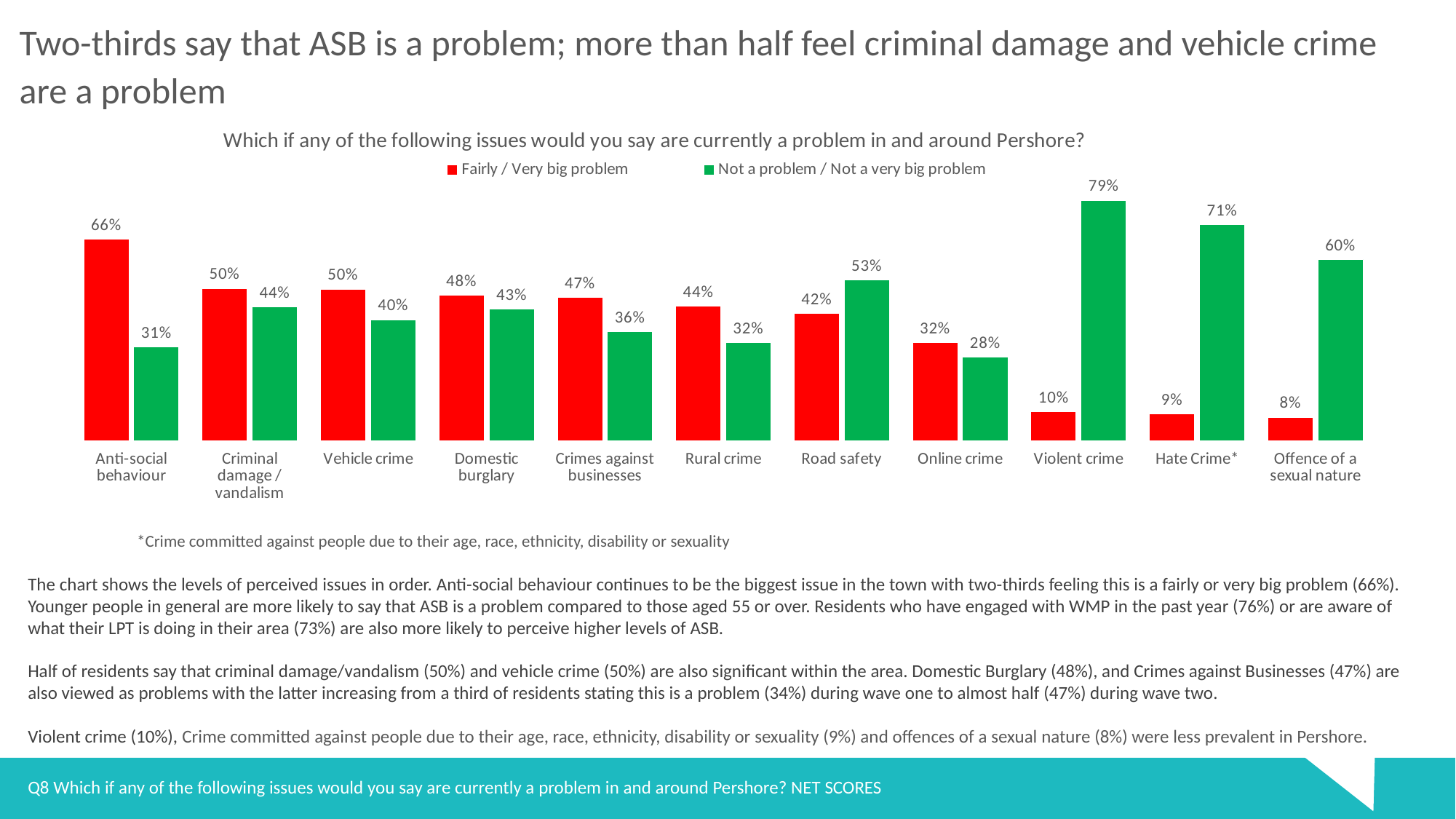
Which category has the lowest 'Fairly / Very big problem' value? Offence of a sexual nature How many categories are shown on the x axis? 11 What percentage say violent crime is not a problem / not a very big problem? 79% For rural crime, which is larger: the 'Fairly / Very big problem' value or the 'Not a problem / Not a very big problem' value? Fairly / Very big problem What percentage say anti-social behaviour is a fairly / very big problem? 66% What kind of chart is shown? Bar chart What colour represents the 'Not a problem / Not a very big problem' series? Green What is the difference between the 'Fairly / Very big problem' and 'Not a problem / Not a very big problem' values for anti-social behaviour? 35 percentage points Which category has the highest 'Fairly / Very big problem' value? Anti-social behaviour What is the 'Fairly / Very big problem' value for road safety? 42% How many series does the legend list? 2 Do the 'Fairly / Very big problem' values rise or fall from left to right along the x axis? Fall